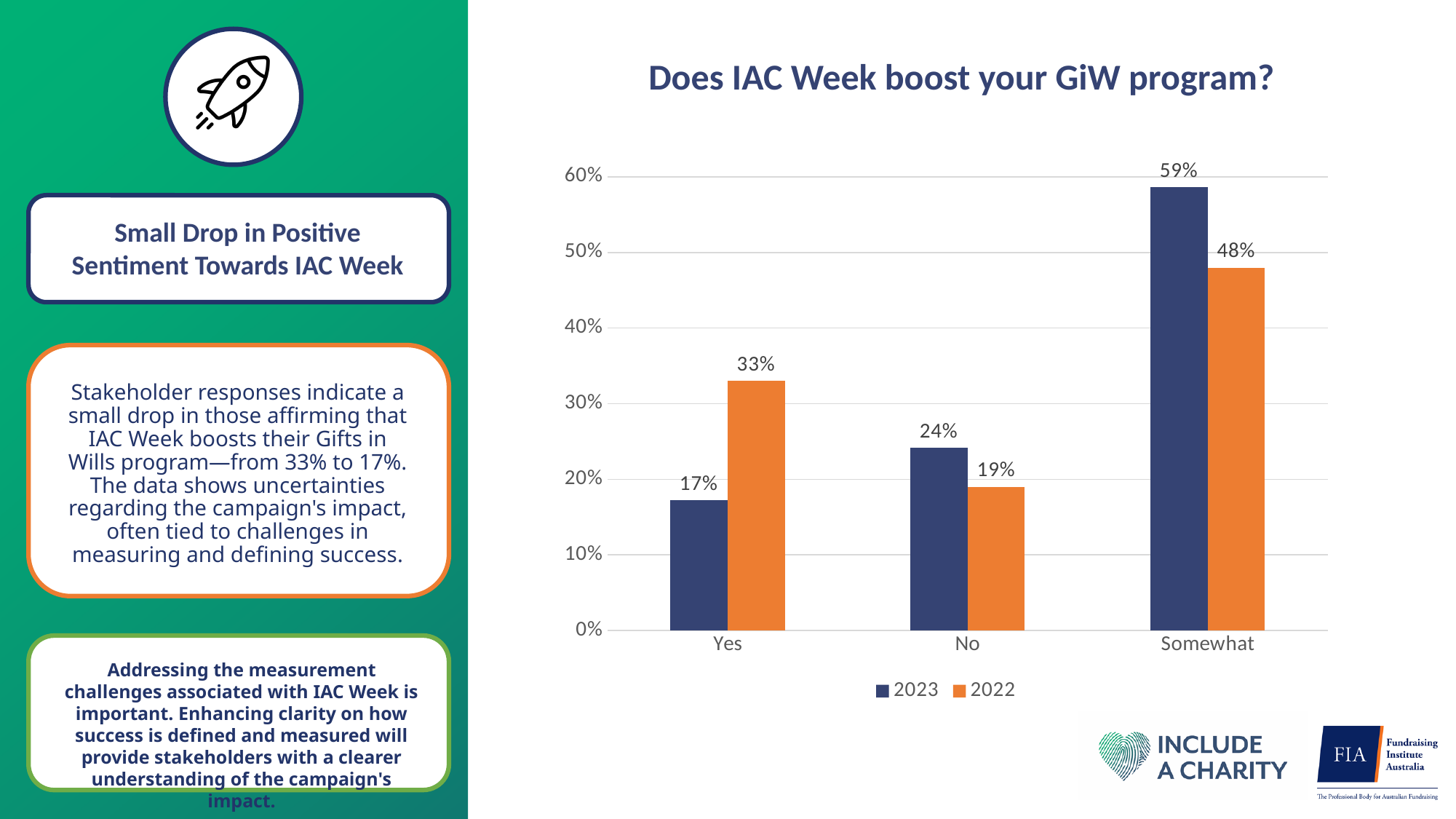
What is the 2022 value for "Somewhat"? 48% What is the difference between the 2023 and 2022 values for "Somewhat"? 11% Which category has the lowest 2022 value? No What kind of chart is shown on the slide? Bar chart How many categories are shown on the x axis? 3 For "No", which series has the larger value, 2023 or 2022? 2023 Which category has the highest 2023 value? Somewhat What is the 2023 value for "Yes"? 17% What is the 2022 value for "No"? 19% What is the difference between the 2022 and 2023 values for "Yes"? 16% How many series does the legend list? 2 What is the title of the chart? Does IAC Week boost your GiW program?